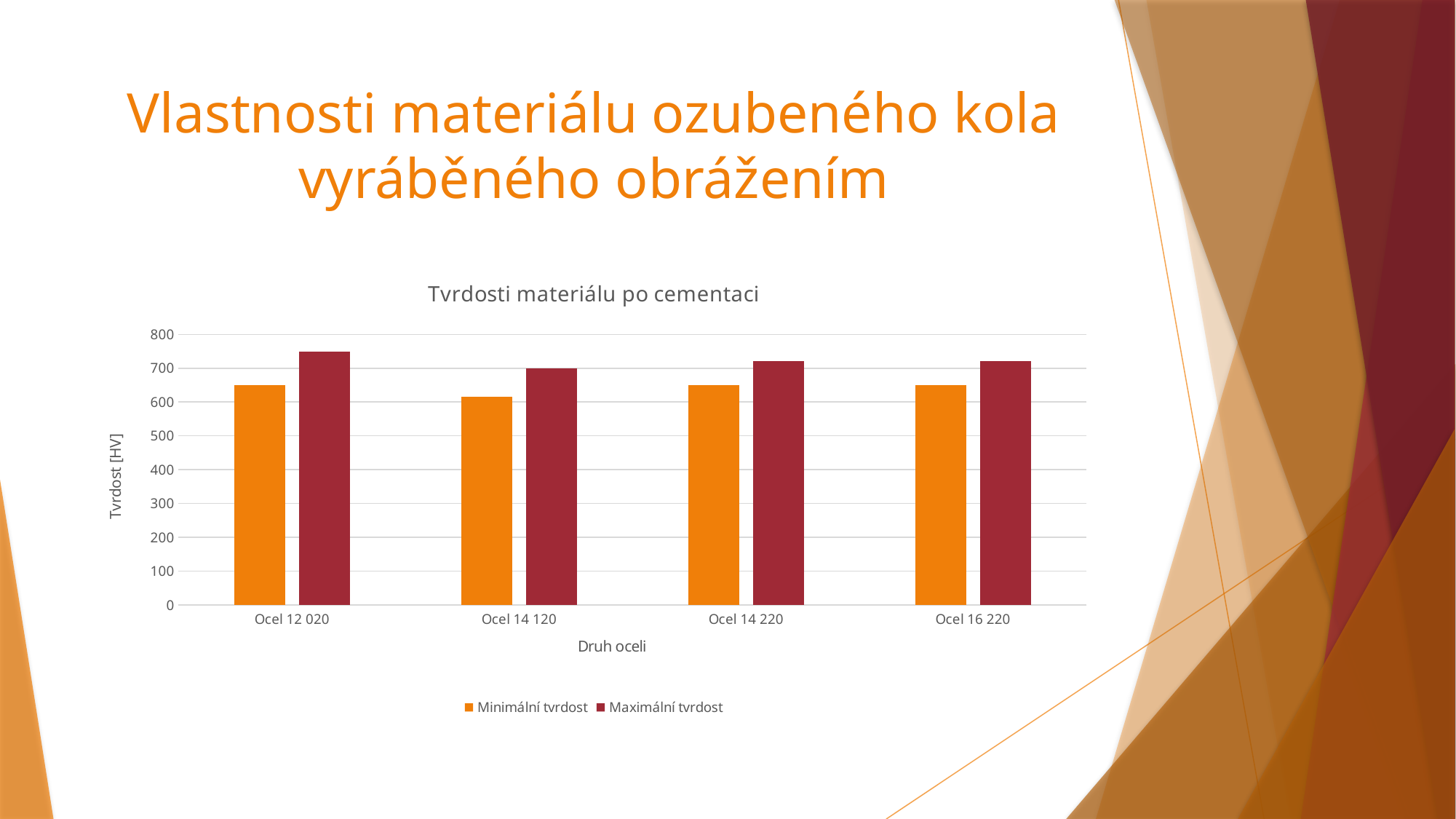
Which steel type has the highest Maximální tvrdost? Ocel 12 020 Is the Minimální tvrdost for Ocel 16 220 greater or less than 700? less Is the Minimální tvrdost for Ocel 14 120 greater or less than 600? greater What kind of chart is shown on the slide? bar chart Which is larger: the Maximální tvrdost for Ocel 12 020 or for Ocel 14 120? Ocel 12 020 How many steel types (categories) are shown on the x axis? 4 What is the label of the y axis? Tvrdost [HV] What is the title of the chart? Tvrdosti materiálu po cementaci Which steel type has the lowest Minimální tvrdost? Ocel 14 120 Is the Maximální tvrdost for Ocel 12 020 greater or less than 700? greater Which is larger: the Minimální tvrdost for Ocel 14 220 or for Ocel 14 120? Ocel 14 220 How many series does the legend list? 2